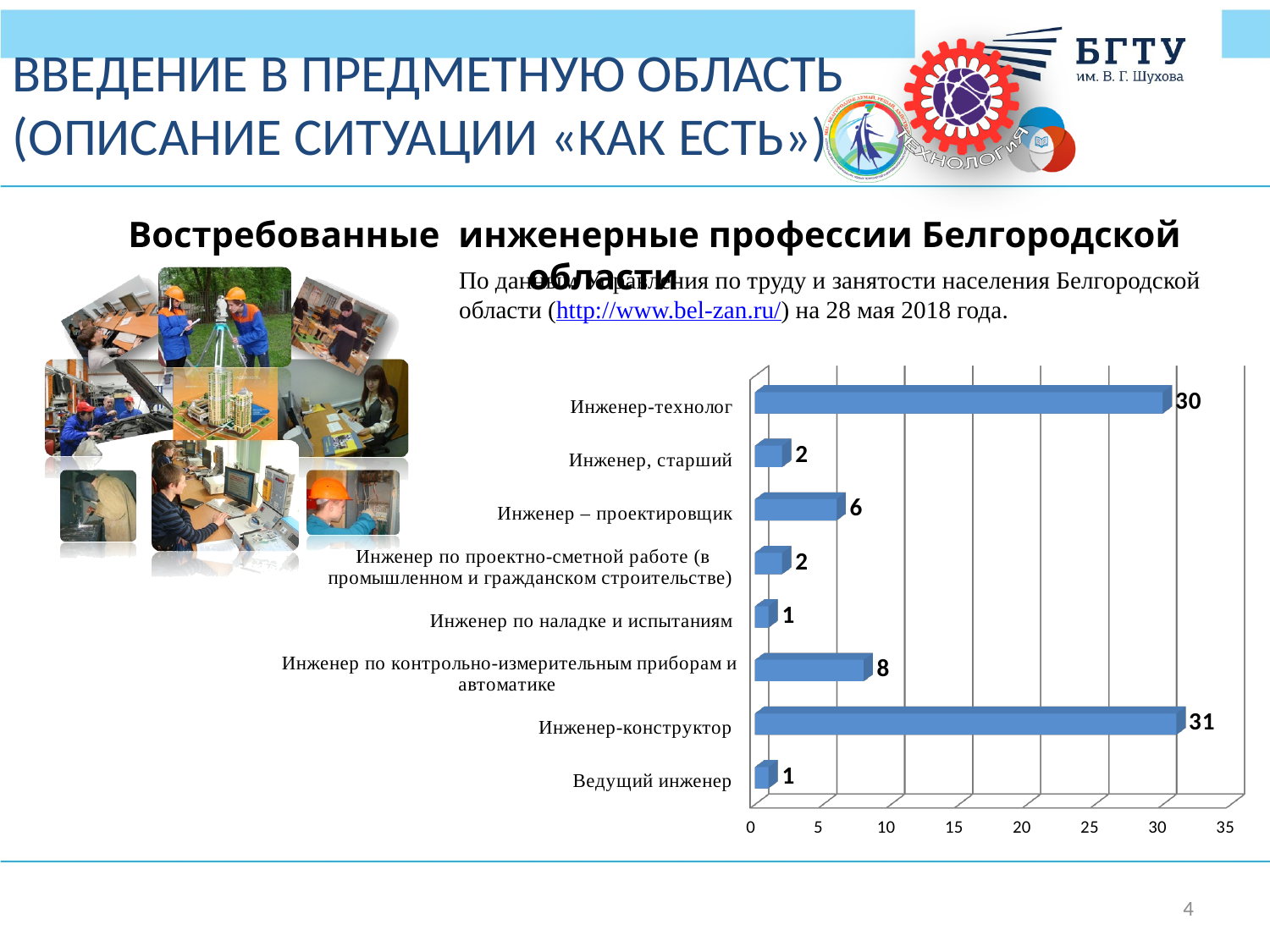
How many categories are shown in the chart? 8 What is the value for Инженер – проектировщик? 6 What is the value for Инженер по контрольно-измерительным приборам и автоматике? 8 Which category has the highest value? Инженер-конструктор What is the value for Инженер-технолог? 30 What is the difference between the values for Инженер-конструктор and Инженер-технолог? 1 What type of chart is shown on the slide? Bar chart What is the value for Ведущий инженер? 1 What is the value for Инженер-конструктор? 31 Which is larger, the value for Инженер, старший or the value for Инженер – проектировщик? Инженер – проектировщик What is the difference between the values for Инженер по контрольно-измерительным приборам и автоматике and Инженер – проектировщик? 2 What is the maximum value shown on the horizontal axis of the chart? 35